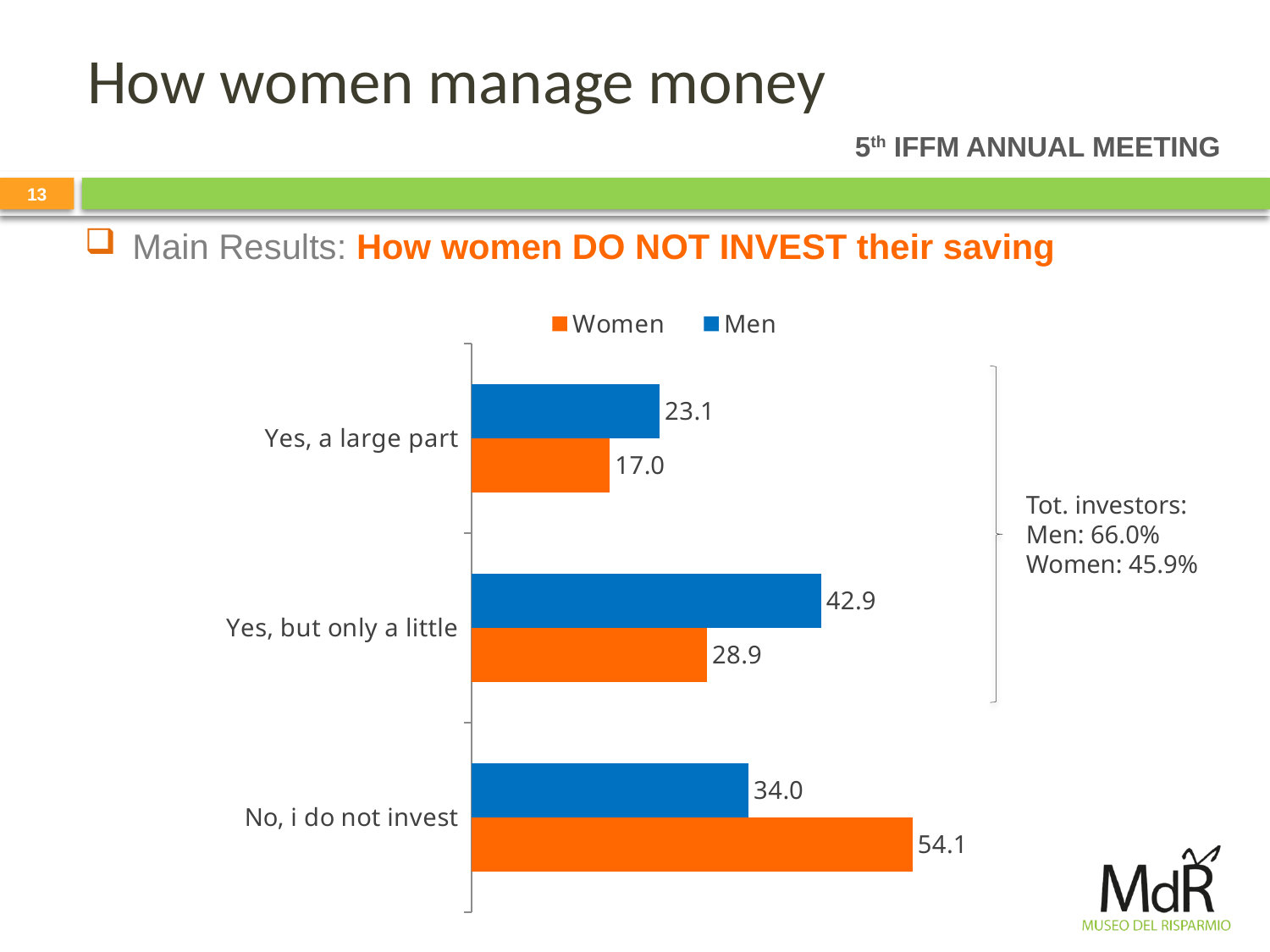
What is the value for Women in the "Yes, a large part" category? 17.0 Which category has the highest value for Women? No, i do not invest What is the difference between the Men and Women values in the "Yes, but only a little" category? 14.0 Which category has the lowest value for Men? Yes, a large part What is the value for Men in the "Yes, but only a little" category? 42.9 What is the difference between the Women and Men values in the "No, i do not invest" category? 20.1 How many categories are shown on the chart? 3 What is the value for Women in the "No, i do not invest" category? 54.1 What is the value for Men in the "No, i do not invest" category? 34.0 What kind of chart is shown on the slide? Bar chart How many series does the legend list? 2 In the "Yes, a large part" category, which series has the larger value, Women or Men? Men